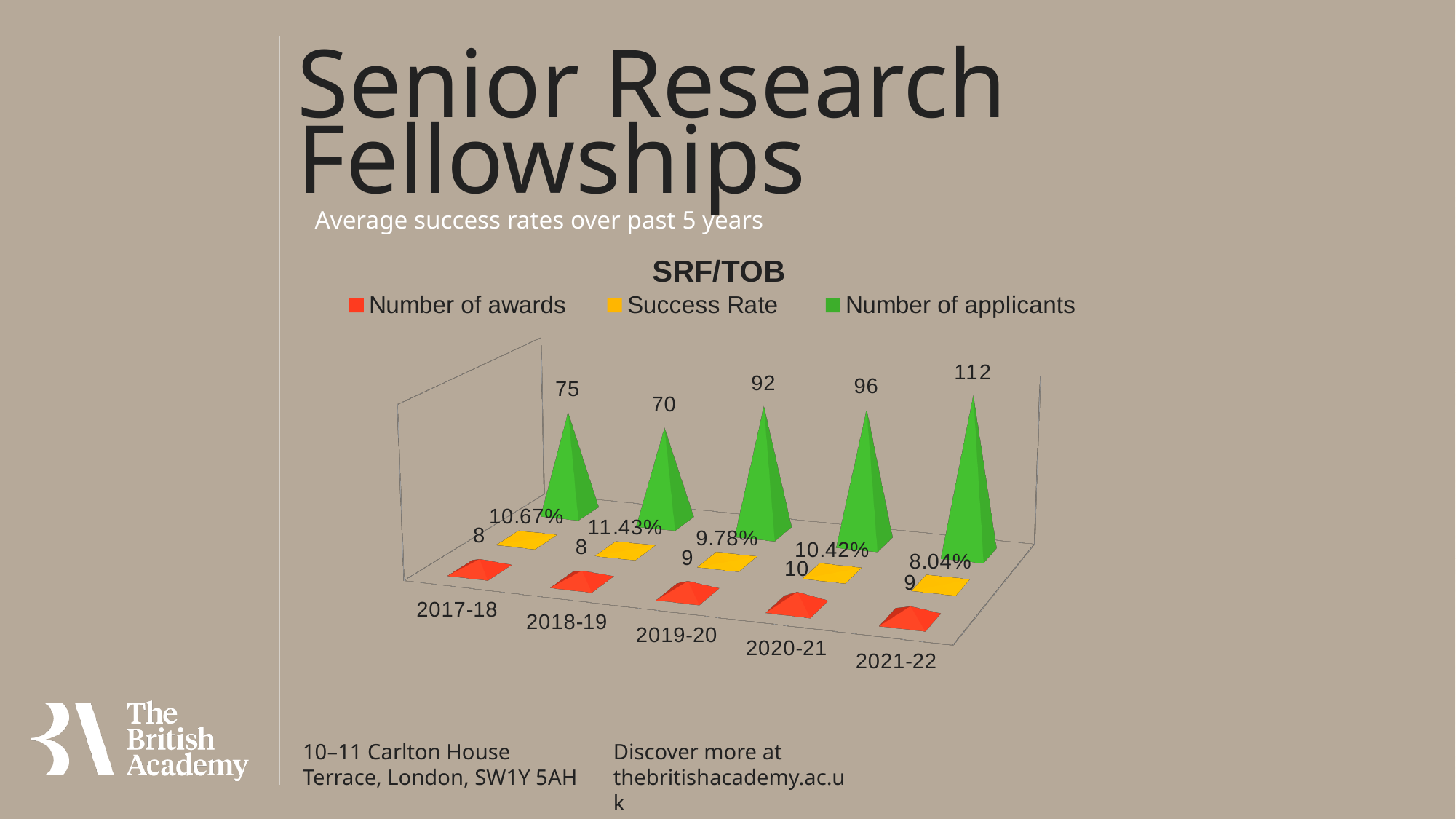
Which year has the highest number of applicants? 2021-22 How many years are shown on the x axis? 5 Which year has the lowest number of applicants? 2018-19 What is the success rate for 2018-19? 11.43% Which colour represents Success Rate in the legend? Yellow How many series does the legend list? 3 What is the difference in number of applicants between 2021-22 and 2017-18? 37 What is the number of awards for 2020-21? 10 Which is larger, the number of applicants in 2019-20 or in 2020-21? 2020-21 What is the number of applicants for 2021-22? 112 Which year has the lowest success rate? 2021-22 What is the title of the chart? SRF/TOB